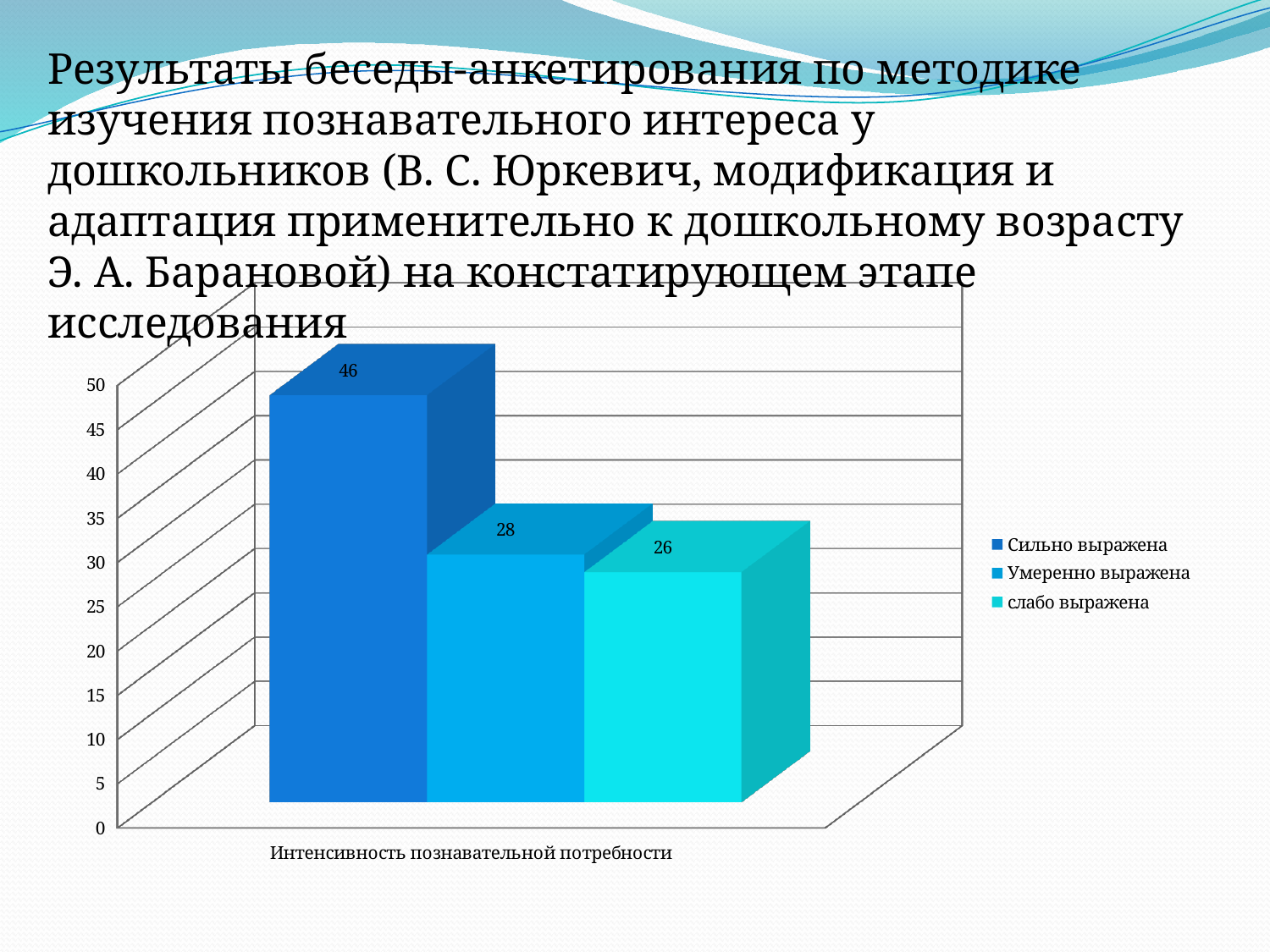
Which is larger, the value for "Сильно выражена" or the value for "слабо выражена"? Сильно выражена What is the value for the series "слабо выражена"? 26 What is the value for the series "Умеренно выражена"? 28 What is the difference between the values for "Сильно выражена" and "Умеренно выражена"? 18 Which series has the lowest value? слабо выражена Which series has the highest value? Сильно выражена What is the difference between the values for "Умеренно выражена" and "слабо выражена"? 2 How many series does the legend list? 3 What kind of chart is shown on the slide? bar chart Is the value for "Сильно выражена" greater or less than 40? greater What is the label on the horizontal axis of the chart? Интенсивность познавательной потребности What is the value for the series "Сильно выражена"? 46